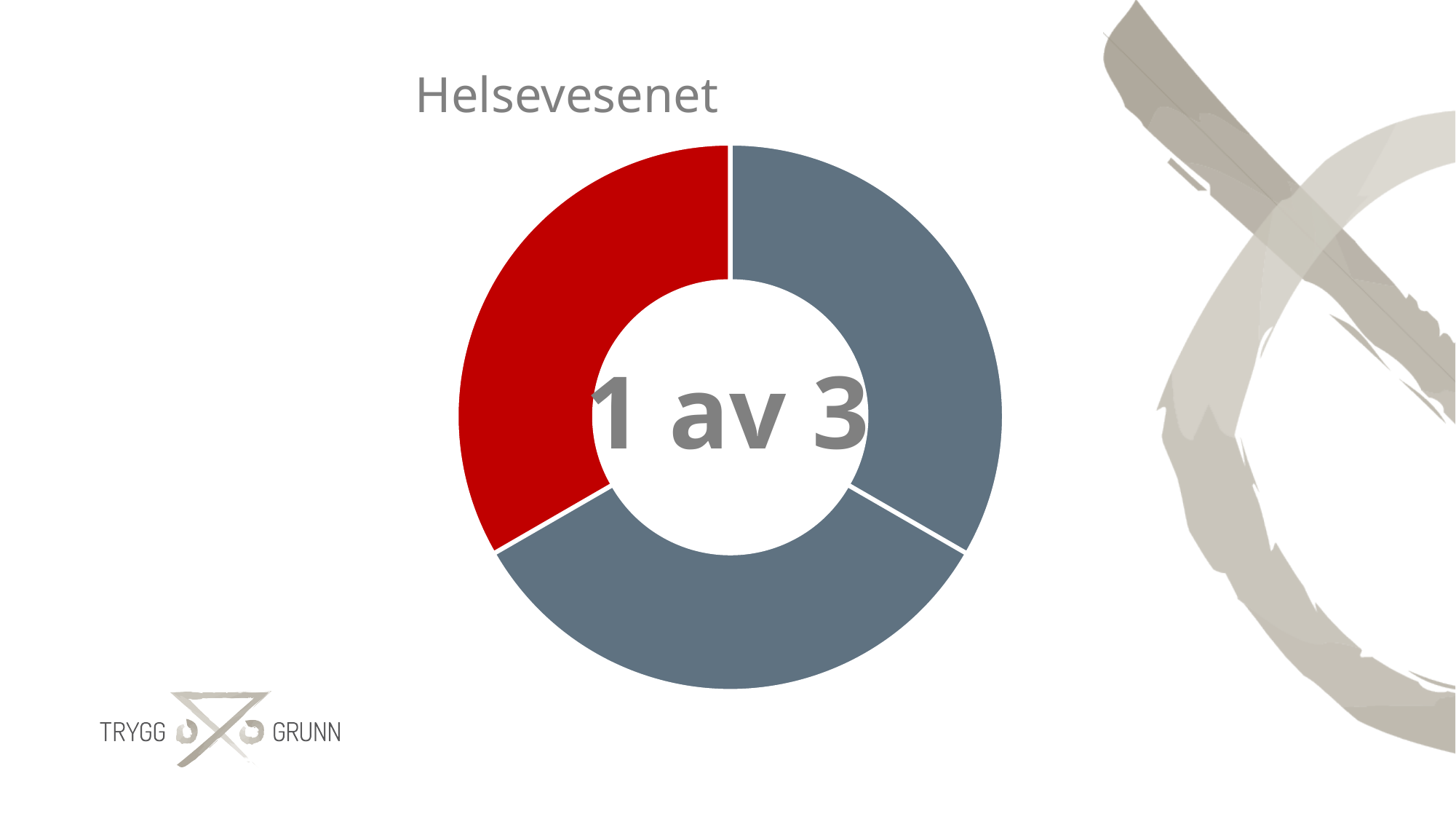
How many slices does the doughnut chart have? 3 What share of the doughnut does the red slice represent, as printed on the slide? 1 av 3 What is the title of the chart? Helsevesenet How many of the three slices are coloured red? 1 What text is printed in the centre of the doughnut chart? 1 av 3 What kind of chart is shown on the slide? Doughnut (pie) chart